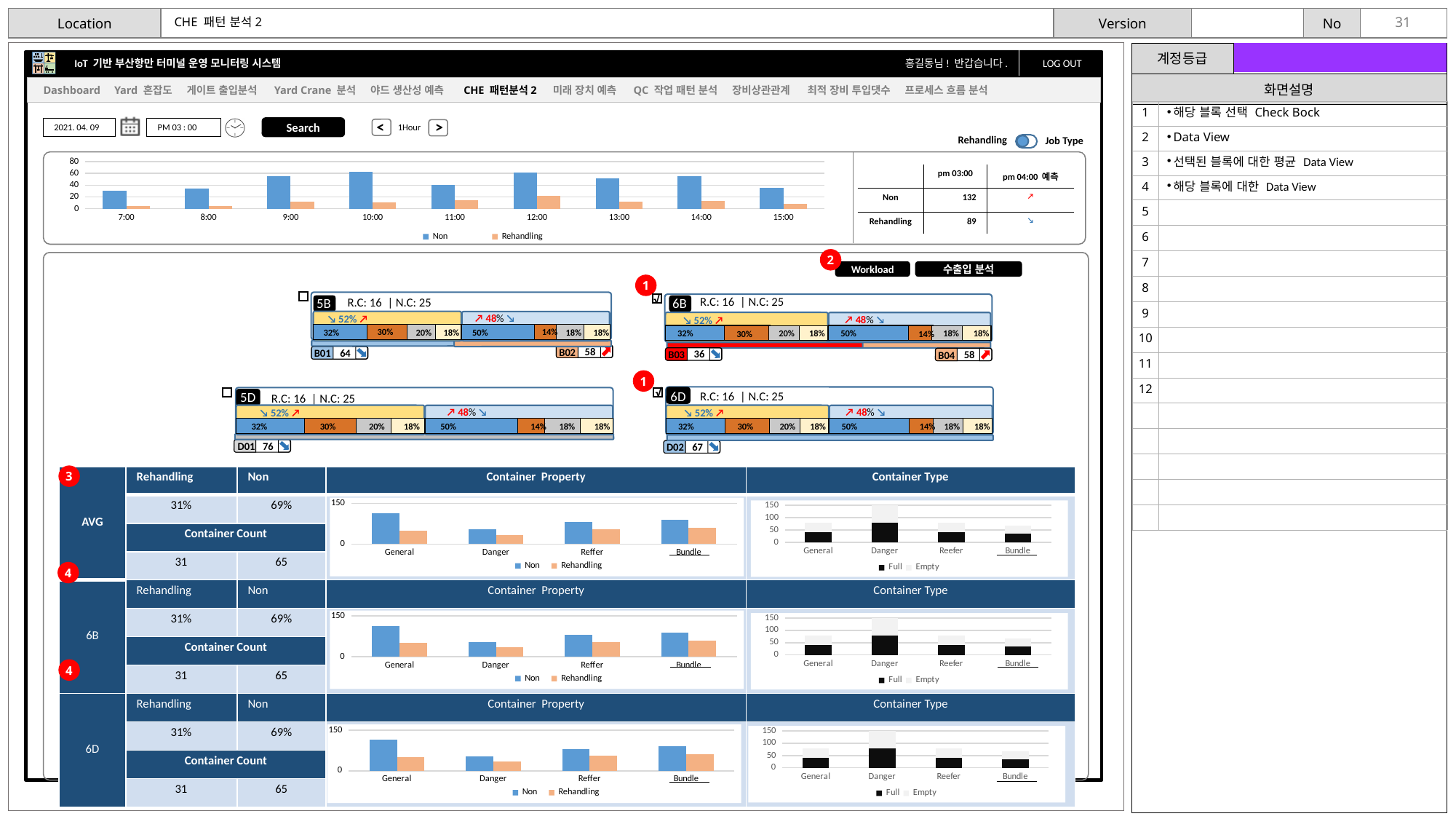
In the hourly chart at the top of the slide, how many series does the legend list? 2 In the AVG row's Container Type chart, is the Full value for Danger greater or less than 50? greater In the hourly chart at the top of the slide, how many time points are shown on the x axis? 9 In the hourly chart at the top of the slide, is the Non value at 7:00 greater or less than 40? less In the hourly chart at the top of the slide, at 12:00 which is larger, Non or Rehandling? Non In the AVG row's Container Property chart, which category has the highest Non value? General In the hourly chart at the top of the slide, what are the two legend entries? Non, Rehandling In the hourly chart at the top of the slide, is the Non value at 10:00 greater or less than 40? greater In the AVG row's Container Property chart, which category has the lowest Non value? Danger In the hourly chart at the top of the slide, at which hour is the Rehandling value highest? 12:00 What kind of chart is the hourly chart at the top of the slide? bar chart In the AVG row's Container Type chart, which category has the highest Full value? Danger